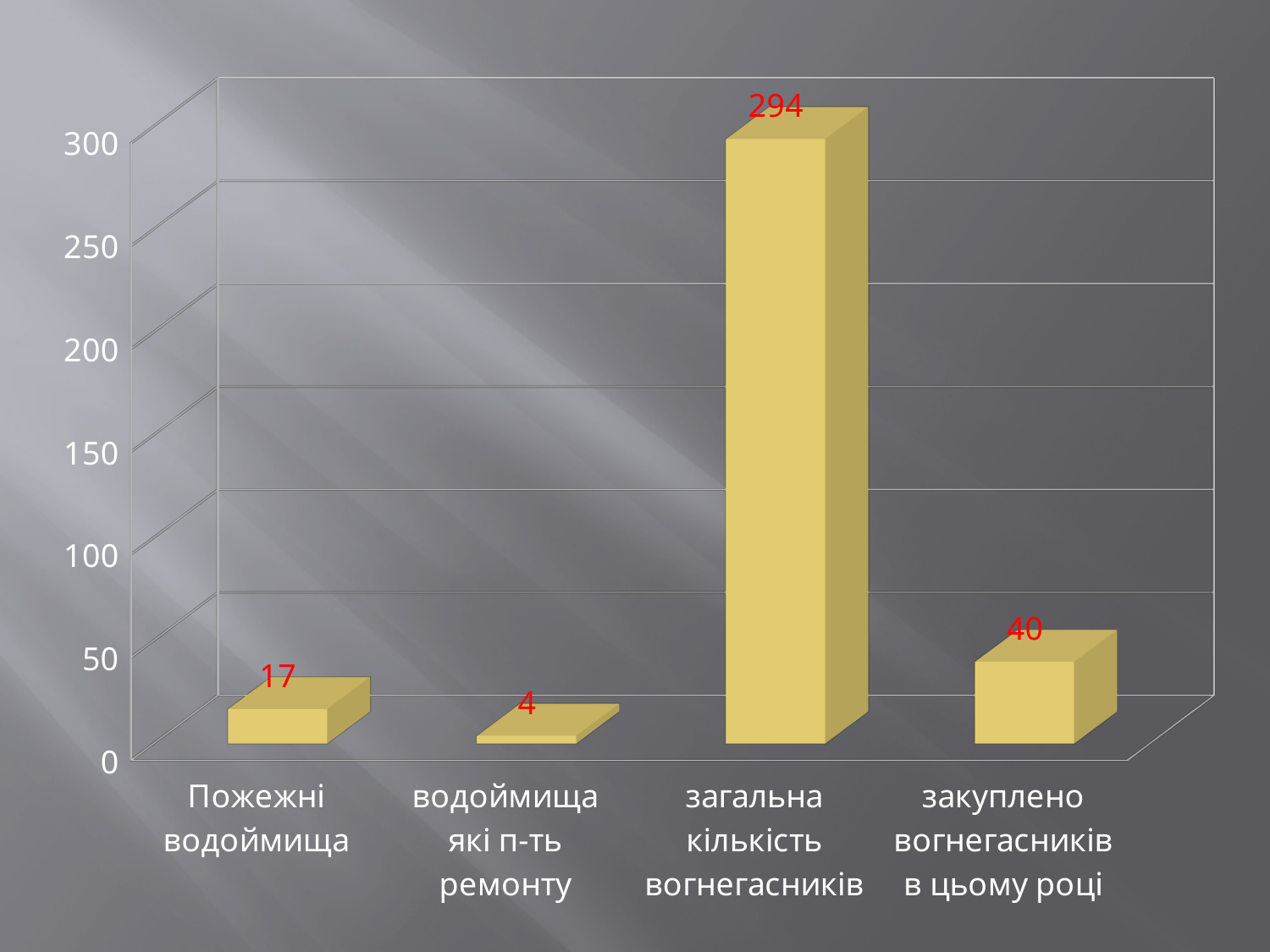
What is the value for "Пожежні водоймища"? 17 Which category has the highest value? загальна кількість вогнегасників What is the value for "водоймища які п-ть ремонту"? 4 Is the value for "загальна кількість вогнегасників" greater or less than 250? greater How many categories are shown on the chart? 4 Which is larger: the value for "закуплено вогнегасників в цьому році" or the value for "Пожежні водоймища"? закуплено вогнегасників в цьому році What is the value for "закуплено вогнегасників в цьому році"? 40 What is the difference between the values for "загальна кількість вогнегасників" and "закуплено вогнегасників в цьому році"? 254 What is the difference between the values for "Пожежні водоймища" and "водоймища які п-ть ремонту"? 13 What is the value for "загальна кількість вогнегасників"? 294 What kind of chart is shown on the slide? bar chart Which category has the lowest value? водоймища які п-ть ремонту